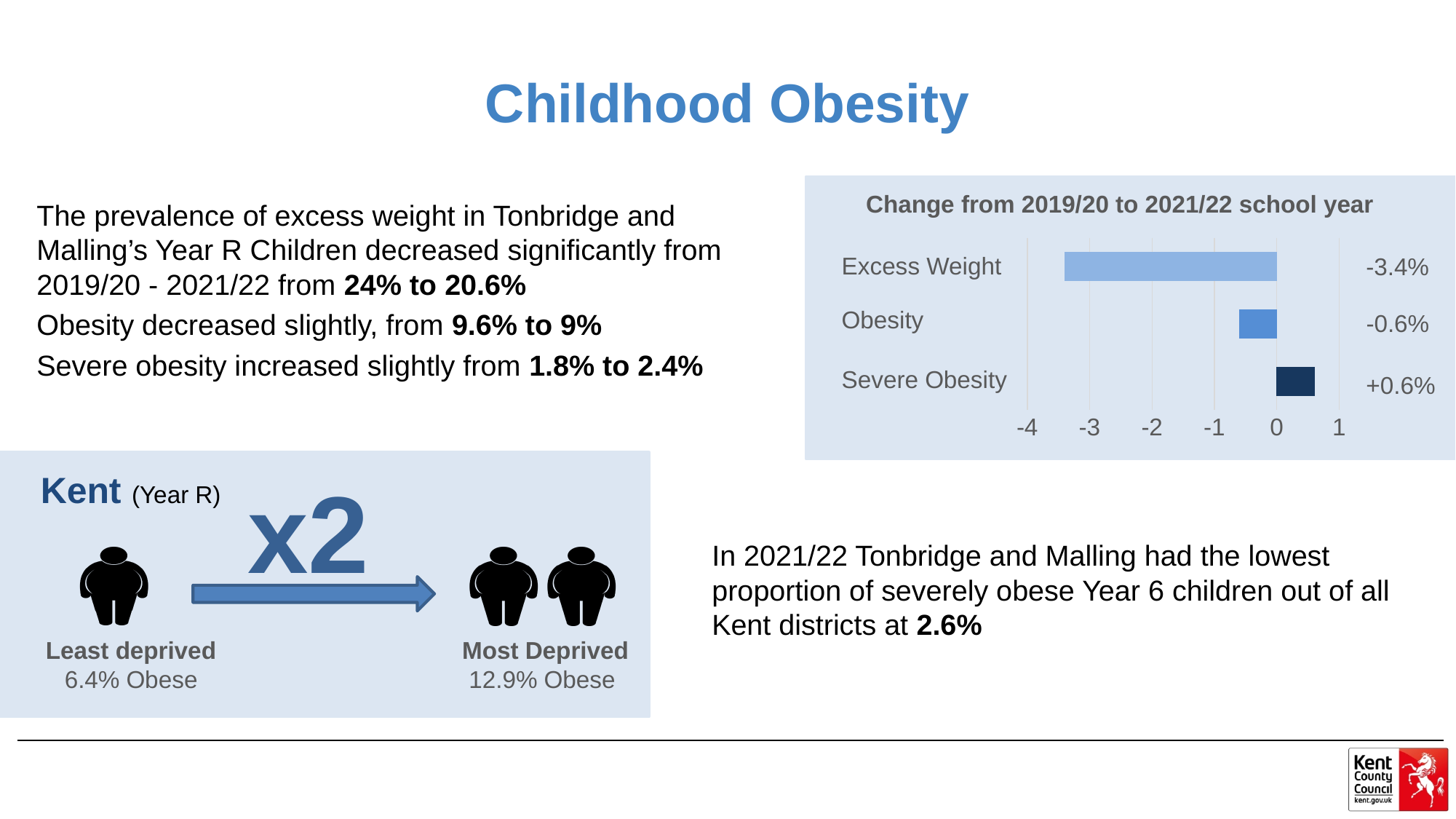
Which category has the highest value in the chart? Severe Obesity Which category has the lowest value in the chart? Excess Weight What is the value for Severe Obesity in the chart? +0.6% What kind of chart is shown on the slide? bar chart What is the title of the chart on the slide? Change from 2019/20 to 2021/22 school year What is the value for Obesity in the chart? -0.6% What is the value for Excess Weight in the chart? -3.4% Which category is the only one with a positive change in the chart? Severe Obesity Is the value for Excess Weight greater or less than -3? less What is the difference between the values for Excess Weight and Obesity in the chart? 2.8 percentage points Which is larger, the value for Obesity or the value for Severe Obesity? Severe Obesity How many categories does the chart show? 3